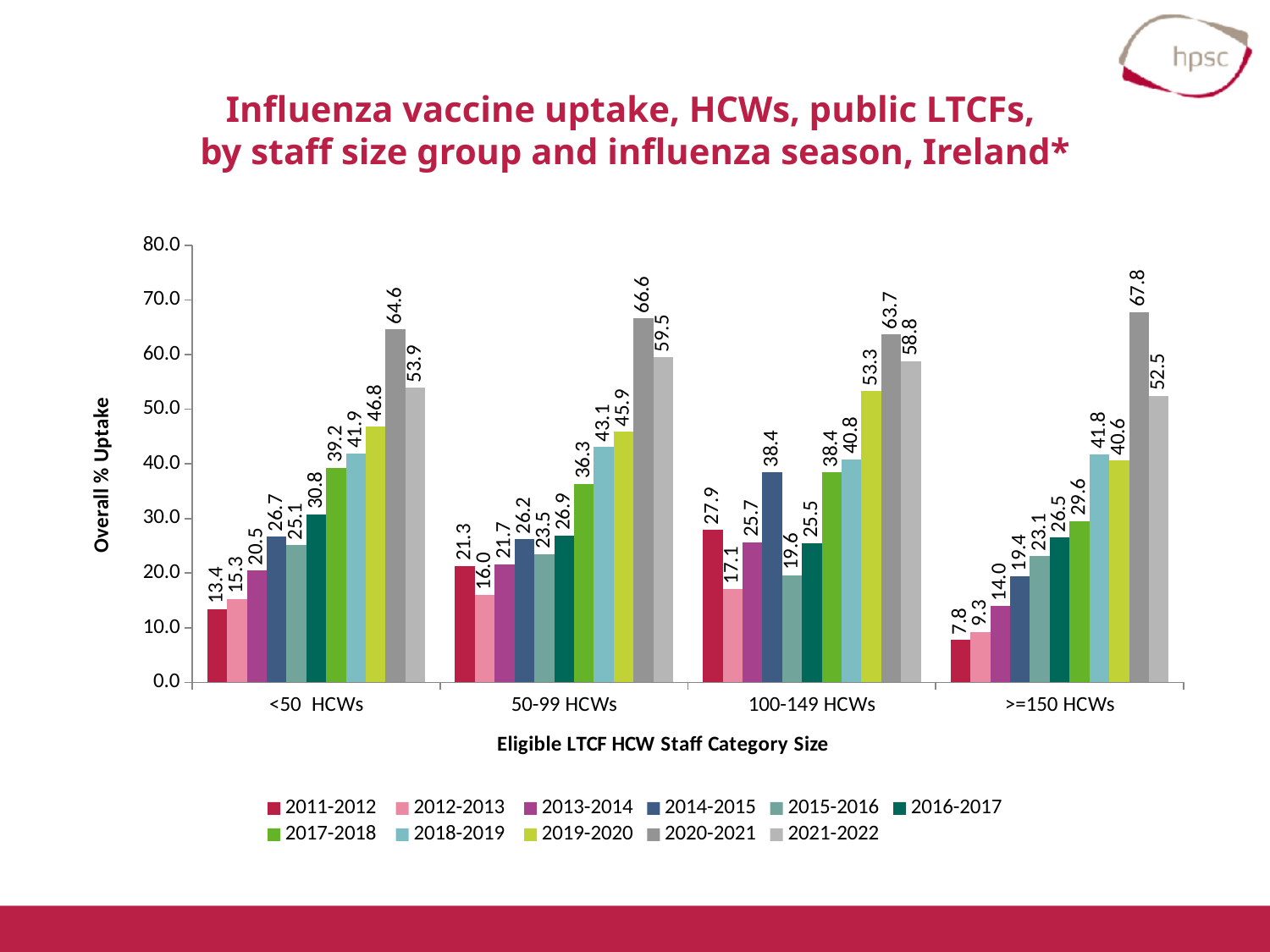
What is the 2011-2012 value for the 100-149 HCWs group? 27.9 How many staff size groups are shown on the x axis? 4 What kind of chart is shown on the slide? Bar chart Which staff size group has the lowest 2011-2012 value? >=150 HCWs What is the 2019-2020 value for the <50 HCWs group? 46.8 Which is larger for the 100-149 HCWs group: the 2014-2015 value or the 2015-2016 value? 2014-2015 Which staff size group has the highest 2020-2021 value? >=150 HCWs How many influenza seasons does the legend list? 11 What is the label of the y axis? Overall % Uptake What is the 2020-2021 value for the >=150 HCWs group? 67.8 What is the label of the x axis? Eligible LTCF HCW Staff Category Size What is the difference between the 2020-2021 and 2021-2022 values for the 50-99 HCWs group? 7.1